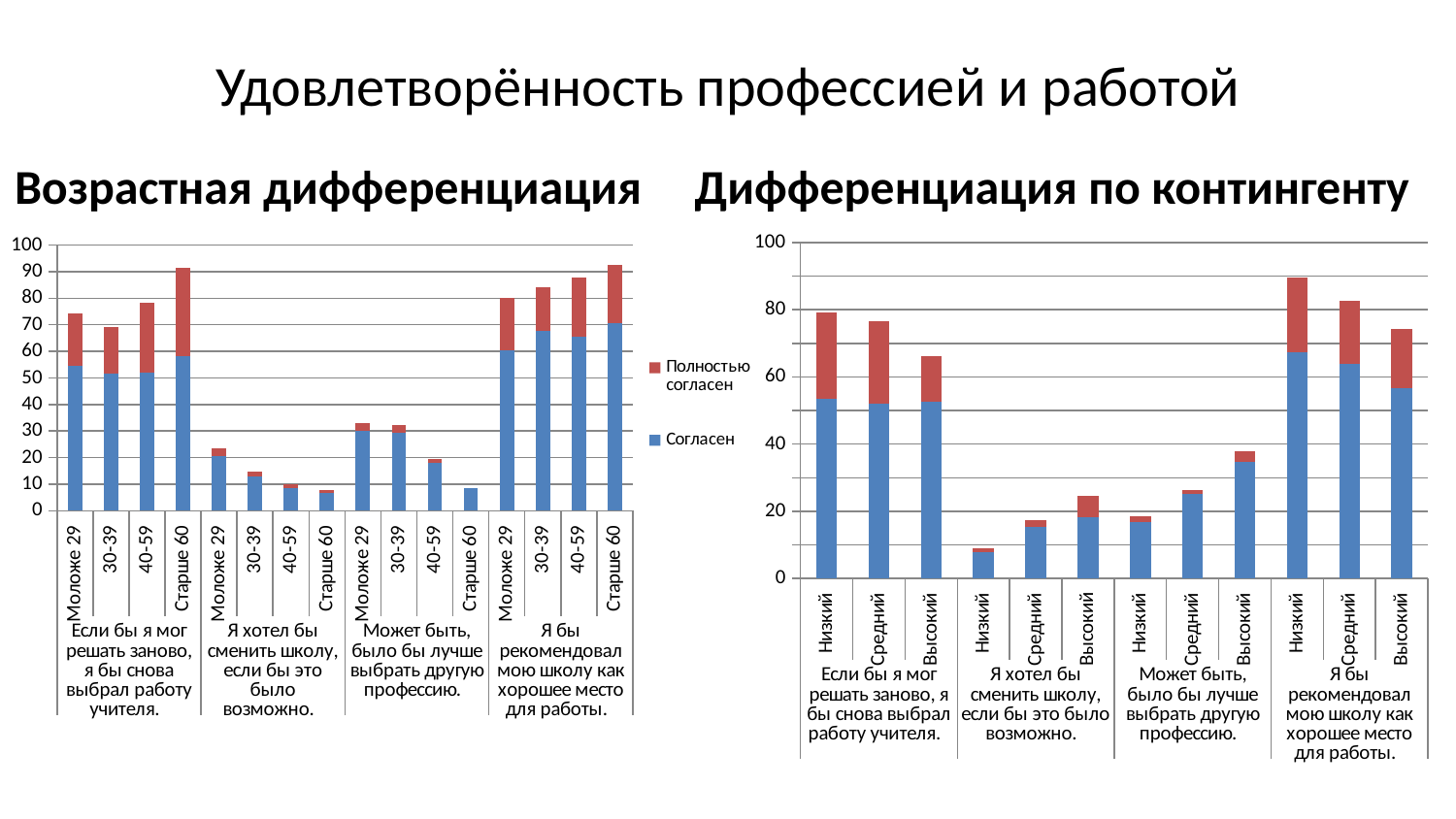
On the chart titled "Дифференциация по контингенту", which bar has the highest total? Низкий in "Я бы рекомендовал мою школу как хорошее место для работы" On the chart titled "Возрастная дифференциация", do the totals rise or fall from "Моложе 29" to "Старше 60" within the group "Я бы рекомендовал мою школу как хорошее место для работы"? rise On the chart titled "Возрастная дифференциация", what kind of chart is shown? Stacked bar chart On the chart titled "Возрастная дифференциация", how many series does the legend list? 2 On the chart titled "Возрастная дифференциация", is the total for "Старше 60" in the group "Может быть, было бы лучше выбрать другую профессию" greater or less than 10? less On the chart titled "Возрастная дифференциация", is the total for "Моложе 29" in the group "Если бы я мог решать заново, я бы снова выбрал работу учителя" greater or less than 70? greater On the chart titled "Возрастная дифференциация", in the group "Я хотел бы сменить школу, если бы это было возможно", which is larger: the total for "Моложе 29" or for "Старше 60"? Моложе 29 On the chart titled "Дифференциация по контингенту", in the group "Если бы я мог решать заново, я бы снова выбрал работу учителя", which is larger: the total for "Низкий" or for "Высокий"? Низкий On the chart titled "Дифференциация по контингенту", is the total for "Высокий" in the group "Может быть, было бы лучше выбрать другую профессию" greater or less than 40? less On the chart titled "Дифференциация по контингенту", how many bars are plotted in total? 12 On the chart titled "Возрастная дифференциация", how many bars are plotted in total? 16 On the chart titled "Дифференциация по контингенту", which bar has the lowest total? Низкий in "Я хотел бы сменить школу, если бы это было возможно"